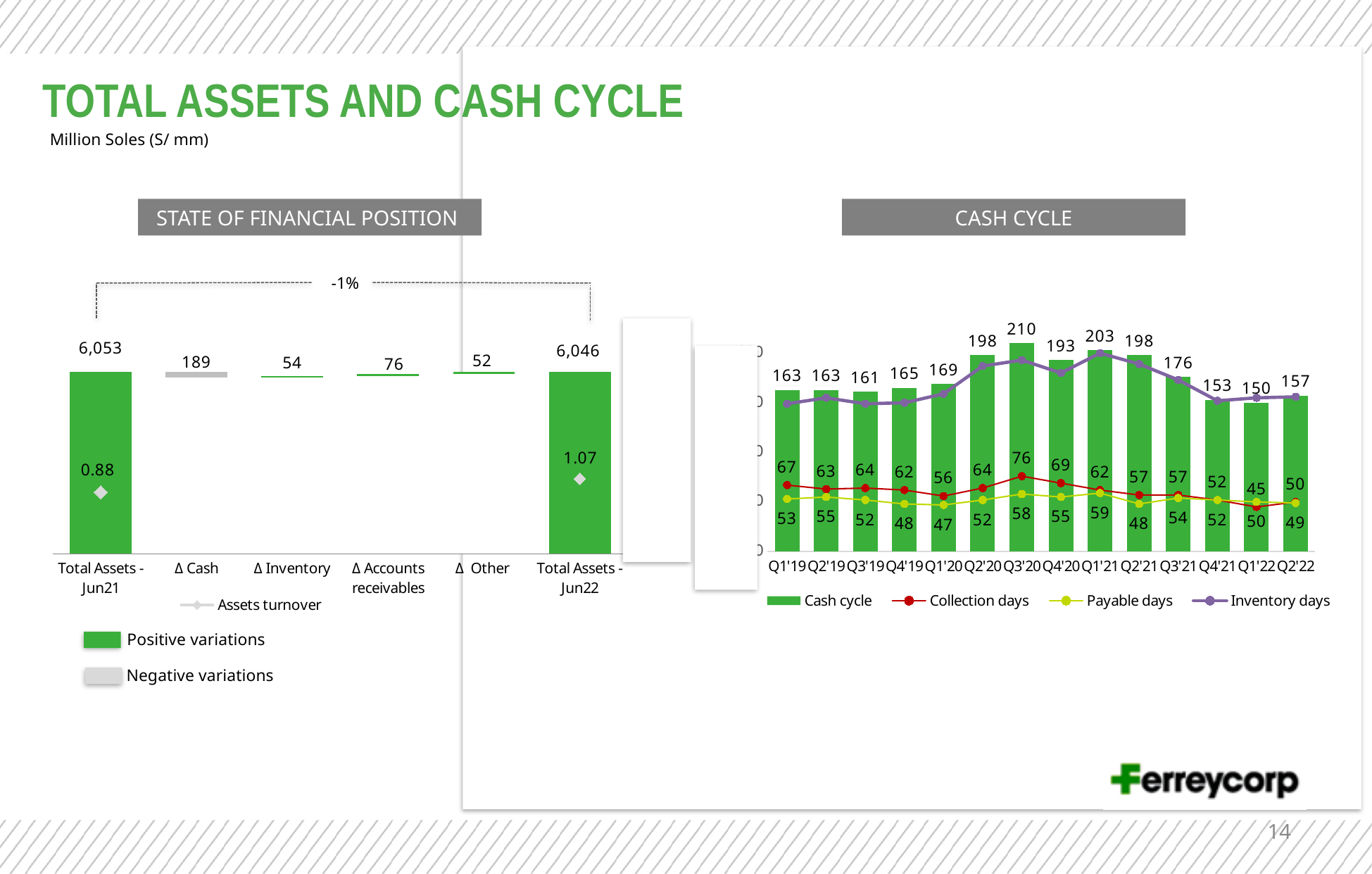
In the CASH CYCLE chart, what is the difference between the cash cycle in Q3'20 and in Q1'19? 47 In the CASH CYCLE chart, how many quarters are shown on the x axis? 14 In the CASH CYCLE chart, which quarter has the highest cash cycle? Q3'20 In the CASH CYCLE chart, what are the collection days for Q1'22? 45 In the CASH CYCLE chart, how many series does the legend list? 4 In the STATE OF FINANCIAL POSITION chart, what is the value of Total Assets - Jun22? 6,046 In the CASH CYCLE chart, what is the cash cycle value for Q3'20? 210 In the CASH CYCLE chart, which quarter has the lowest cash cycle? Q1'22 In the CASH CYCLE chart, which is larger: collection days in Q3'20 or collection days in Q1'22? Q3'20 In the STATE OF FINANCIAL POSITION chart, what is the value shown for Δ Cash? 189 In the CASH CYCLE chart, what are the payable days for Q1'21? 59 In the STATE OF FINANCIAL POSITION chart, what is the assets turnover value shown for Total Assets - Jun22? 1.07